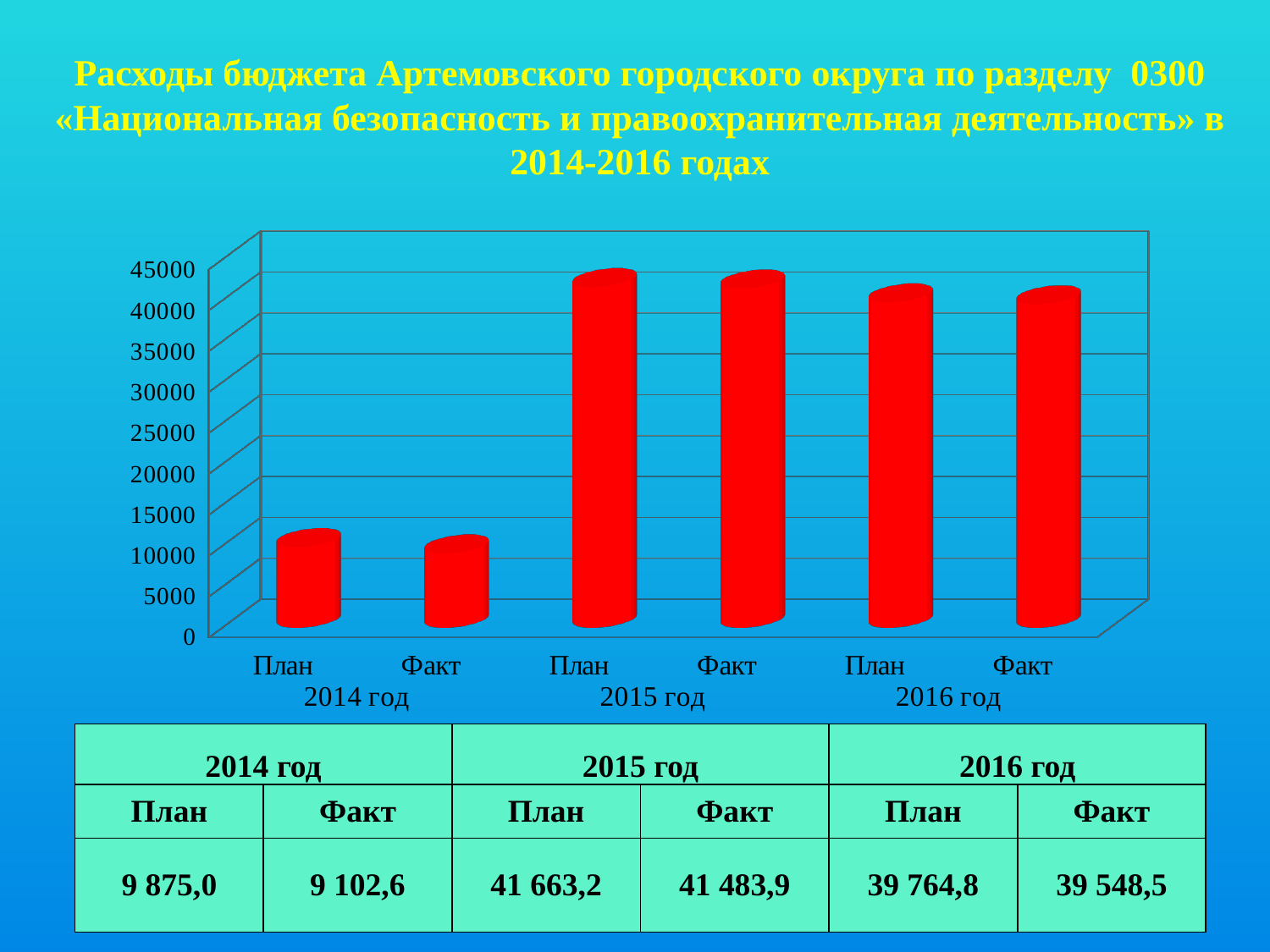
Which is larger, the Факт value for 2015 год or the Факт value for 2016 год? Факт 2015 год What is the Факт (actual) value for 2016 год? 39 548,5 Which bar has the highest value in the chart? План 2015 год What is the Факт (actual) value for 2015 год? 41 483,9 How many bars are plotted in the chart? 6 What colour are the bars in the chart? red What is the difference between the План and Факт values for 2014 год? 772,4 What is the difference between the План and Факт values for 2016 год? 216,3 Is the value for Факт 2014 год greater or less than 10000? less Which bar has the lowest value in the chart? Факт 2014 год What type of chart is shown on the slide? bar chart What is the План (plan) value for 2014 год? 9 875,0